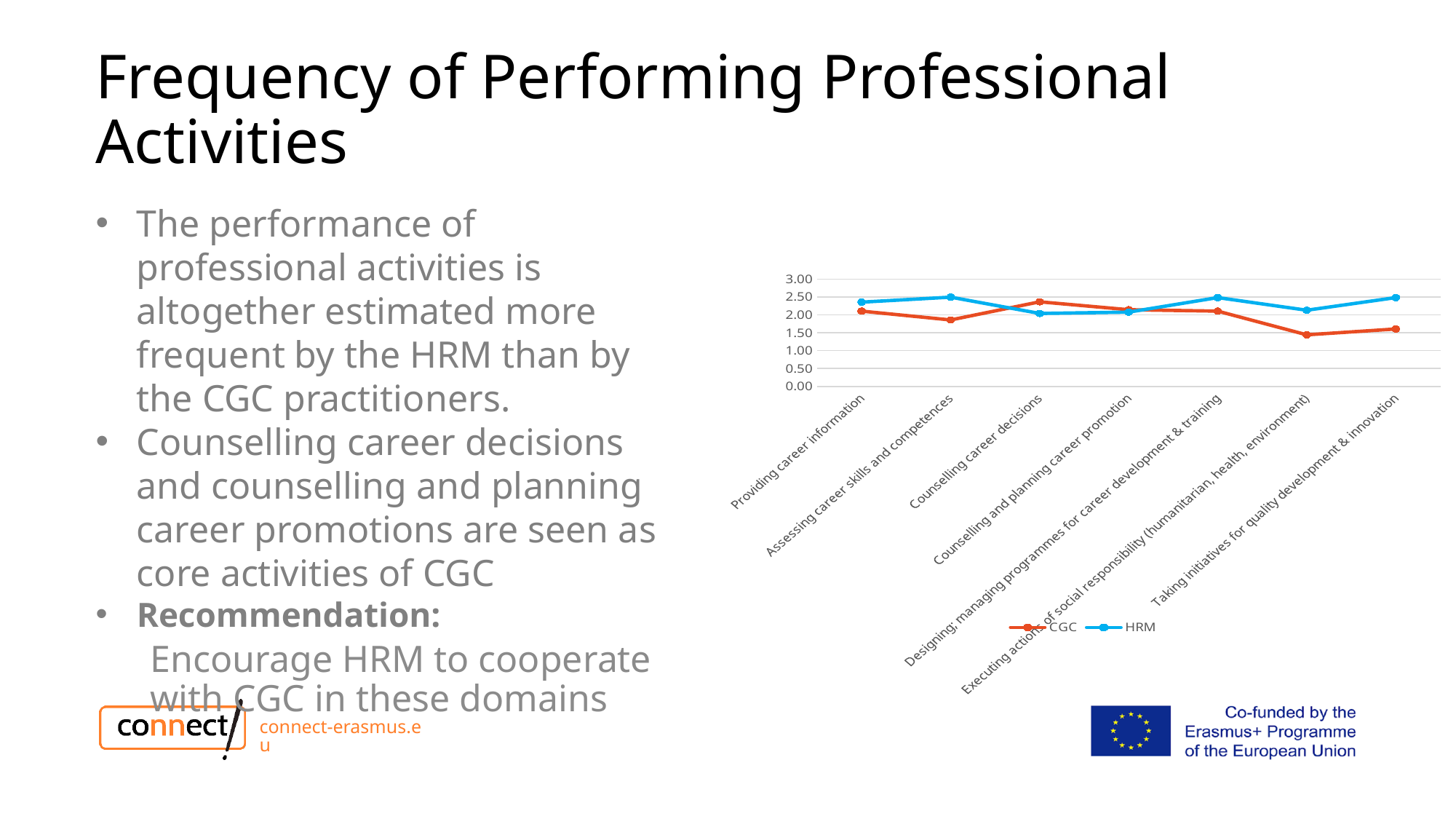
Is the HRM value for 'Taking initiatives for quality development & innovation' greater or less than 2.00? greater How many series does the chart legend list? 2 How many professional activities (categories) are plotted along the x axis? 7 Which series is drawn in blue in the chart? HRM What kind of chart is shown on the slide? line chart Is the CGC value for 'Executing actions of social responsibility (humanitarian, health, environment)' greater or less than 2.00? less For 'Counselling career decisions', which series has the higher value, CGC or HRM? CGC Is the CGC value for 'Assessing career skills and competences' greater or less than 2.00? less For 'Providing career information', which series has the higher value, CGC or HRM? HRM Does the CGC line rise or fall from 'Designing, managing programmes for career development & training' to 'Executing actions of social responsibility (humanitarian, health, environment)'? fall For which activity is the CGC value lowest? Executing actions of social responsibility (humanitarian, health, environment)